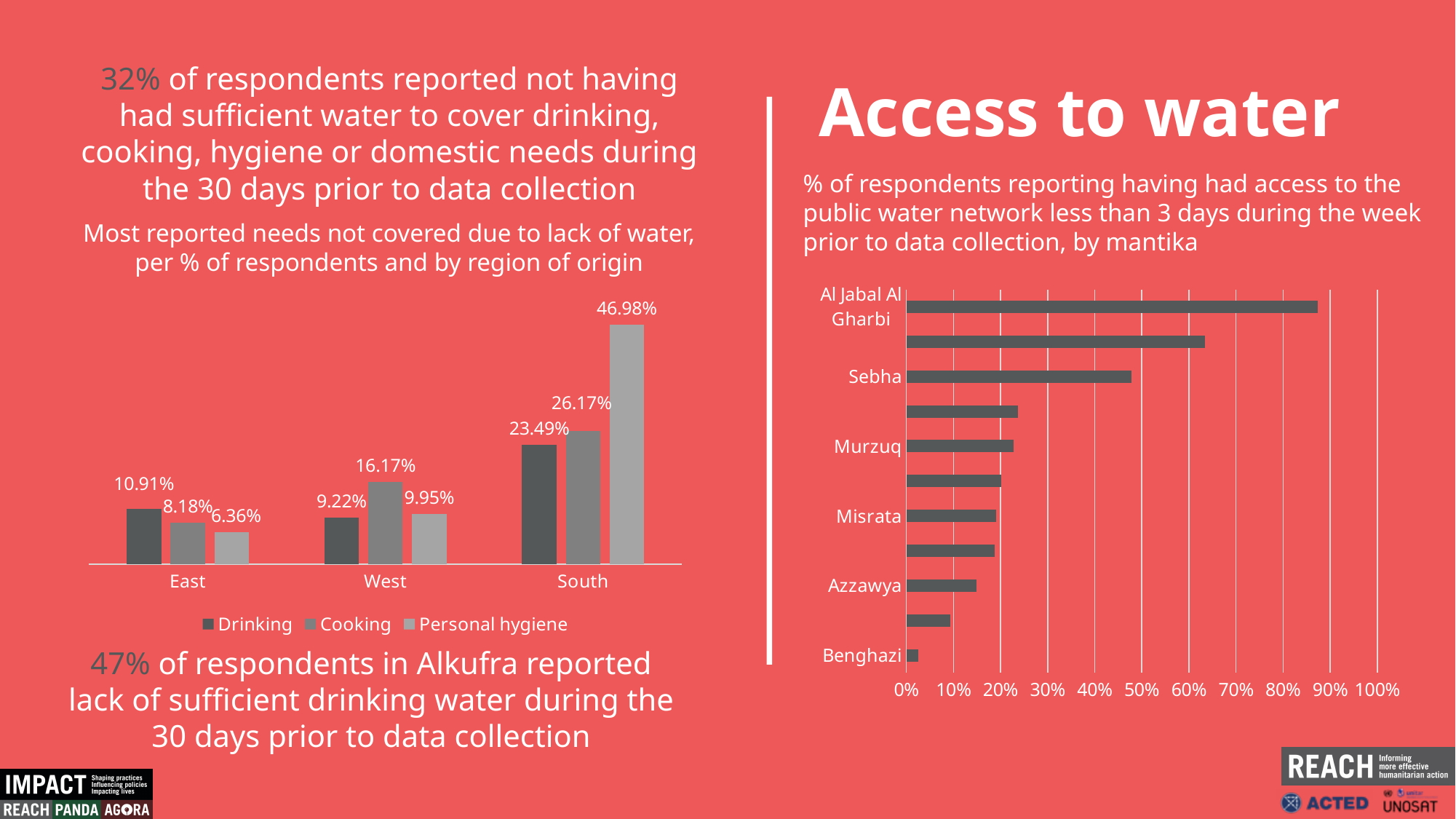
On the right chart (access to the public water network less than 3 days, by mantika), is the value for Al Jabal Al Gharbi greater or less than 80%? greater What kind of chart is the right chart (access to the public water network less than 3 days, by mantika)? Bar chart On the left chart (needs not covered due to lack of water), what is the difference between Cooking and Drinking in the South? 2.68% On the right chart (access to the public water network less than 3 days, by mantika), which labelled mantika has the lowest value? Benghazi On the left chart (needs not covered due to lack of water), how many series does the legend list? 3 On the left chart (needs not covered due to lack of water), what is the value for Personal hygiene in the South? 46.98% On the left chart (needs not covered due to lack of water), what is the value for Cooking in the West? 16.17% On the right chart (access to the public water network less than 3 days, by mantika), is the value for Sebha greater or less than 40%? greater On the left chart (needs not covered due to lack of water), which region has the lowest value for Personal hygiene? East On the left chart (needs not covered due to lack of water), what is the value for Drinking in the East? 10.91% On the left chart (needs not covered due to lack of water), which region has the highest value for Drinking? South On the left chart (needs not covered due to lack of water), which is larger in the West: Drinking or Personal hygiene? Personal hygiene